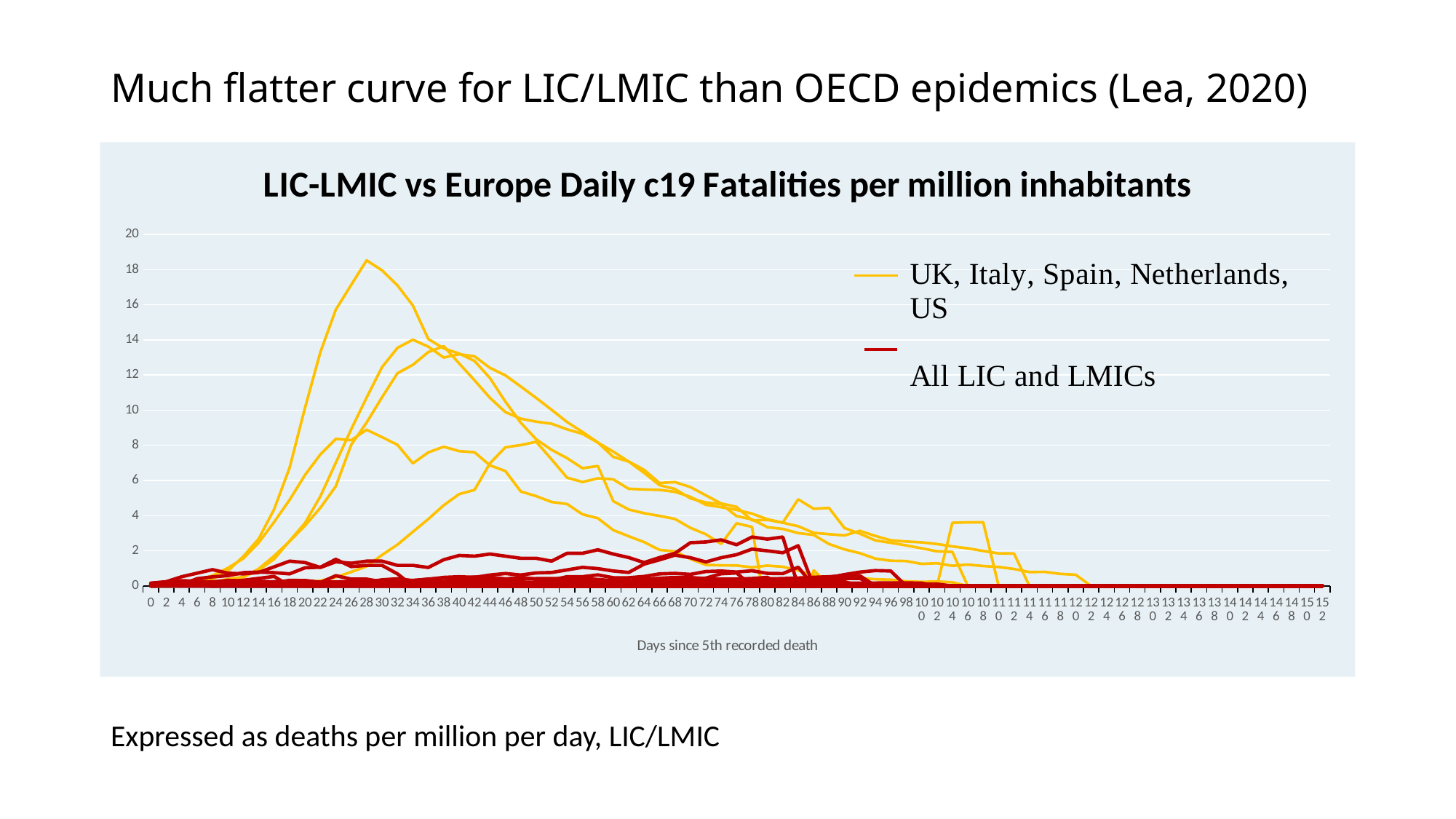
Is the highest yellow line at day 28 greater or less than 14? greater How many series does the legend list? 2 What is the highest tick value shown on the vertical axis? 20 What is the label of the horizontal axis? Days since 5th recorded death Is the highest value reached by any of the All LIC and LMICs lines greater or less than 4? less What is the title of the chart? LIC-LMIC vs Europe Daily c19 Fatalities per million inhabitants Is the value of the All LIC and LMICs lines at day 40 greater or less than 4? less Which group of lines reaches higher peak values, UK, Italy, Spain, Netherlands, US or All LIC and LMICs? UK, Italy, Spain, Netherlands, US After about day 40, do the UK, Italy, Spain, Netherlands, US lines generally rise or fall? fall What kind of chart is shown on the slide? line chart